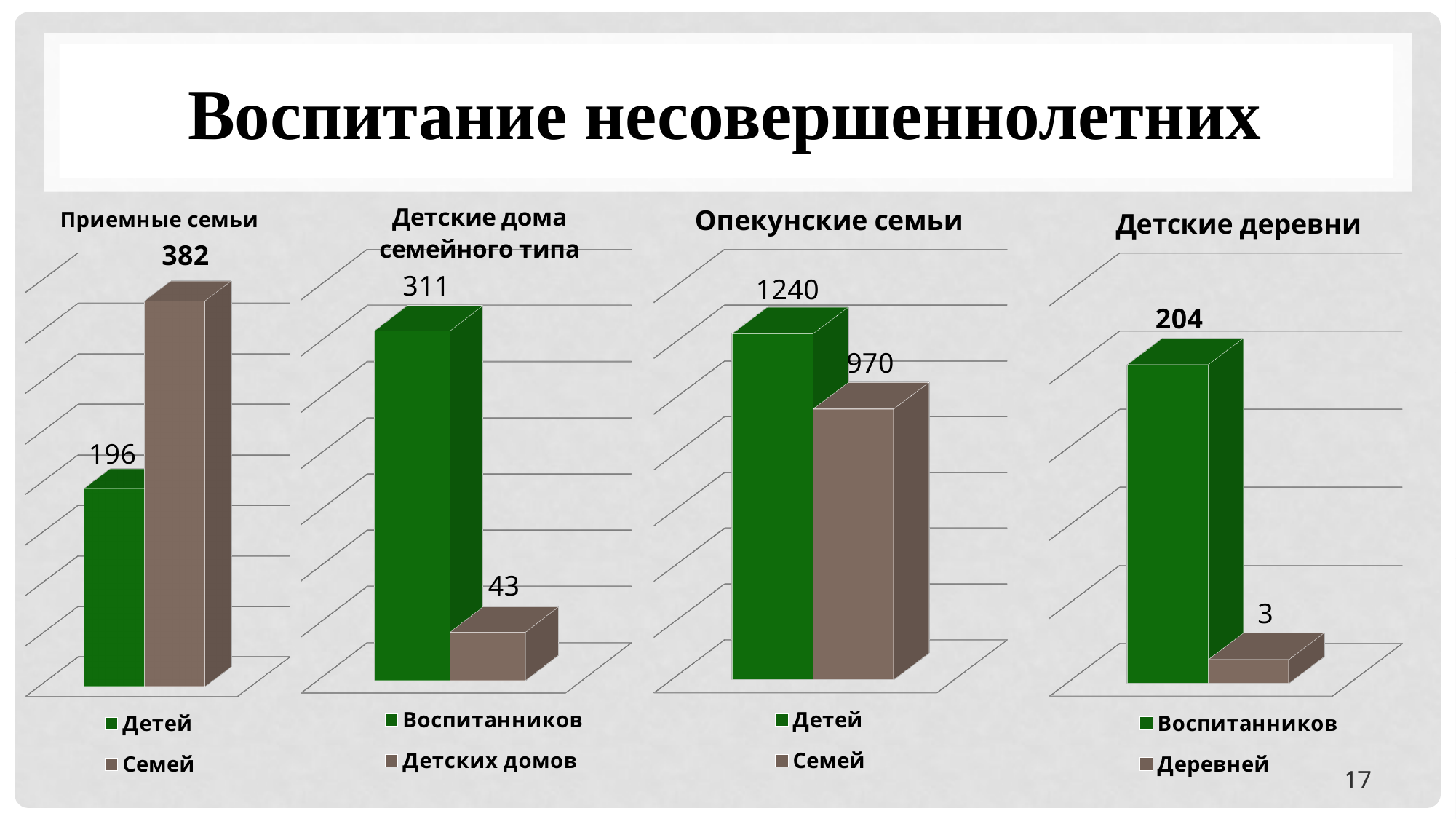
How many series does the legend of the chart titled "Детские дома семейного типа" list? 2 In the chart titled "Детские деревни", which is larger: "Воспитанников" or "Деревней"? Воспитанников In the chart titled "Детские деревни", what is the value for "Деревней"? 3 In the chart titled "Детские дома семейного типа", what is the value for "Детских домов"? 43 What kind of chart is the chart titled "Детские деревни"? bar chart In the chart titled "Опекунские семьи", what is the value for "Семей"? 970 In the chart titled "Приемные семьи", what is the value for "Детей"? 196 In the chart titled "Детские дома семейного типа", what is the value for "Воспитанников"? 311 In the chart titled "Приемные семьи", which is larger: "Детей" or "Семей"? Семей In the chart titled "Опекунские семьи", what is the value for "Детей"? 1240 In the chart titled "Опекунские семьи", what is the difference between the values for "Детей" and "Семей"? 270 In the chart titled "Приемные семьи", what is the value for "Семей"? 382